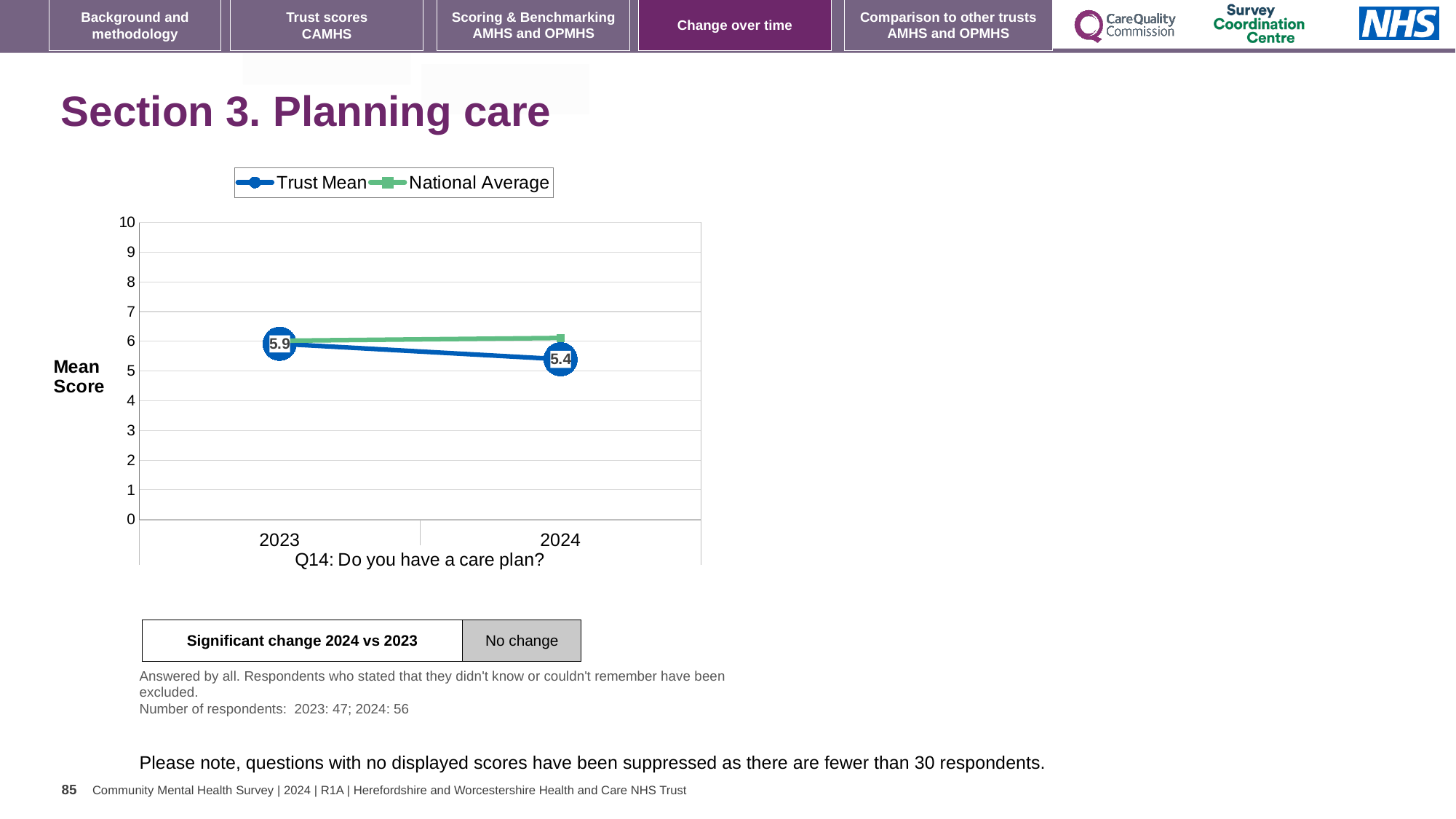
In 2024, which is higher: the Trust Mean or the National Average? National Average What type of chart is shown on the slide? line chart How many series does the chart legend list? 2 How many years are shown on the x axis of the chart? 2 What is the Trust Mean score for 2023? 5.9 Is the National Average value for 2024 greater or less than 5? greater Is the National Average value for 2023 greater or less than 7? less What question is the chart about, as labelled below the x axis? Q14: Do you have a care plan? Does the Trust Mean rise or fall from 2023 to 2024? fall What is the Trust Mean score for 2024? 5.4 By how much did the Trust Mean score fall from 2023 to 2024? 0.5 Which year has the higher Trust Mean score, 2023 or 2024? 2023